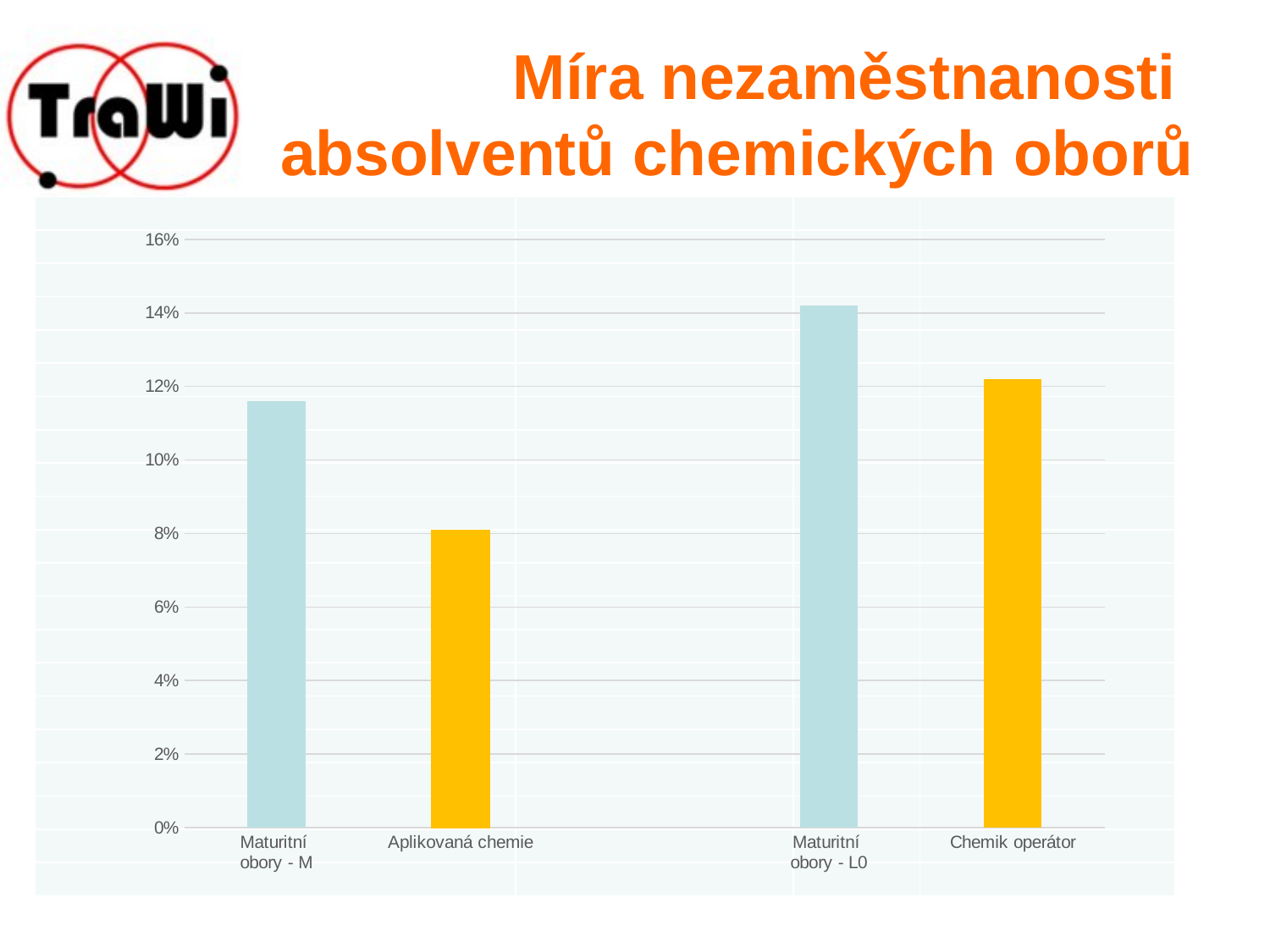
Is the value for Maturitní obory - M greater or less than 10%? greater Is the value for Chemik operátor greater or less than 14%? less What kind of chart is shown on the slide? bar chart Which is larger, the value for Aplikovaná chemie or the value for Chemik operátor? Chemik operátor Which category has the lowest unemployment rate? Aplikovaná chemie Which category has the highest unemployment rate? Maturitní obory - L0 Is the value for Maturitní obory - L0 greater or less than 12%? greater Which is larger, the value for Maturitní obory - L0 or the value for Maturitní obory - M? Maturitní obory - L0 What is the title of the slide containing the chart? Míra nezaměstnanosti absolventů chemických oborů What colour is the bar for Aplikovaná chemie? yellow How many categories are plotted on the chart? 4